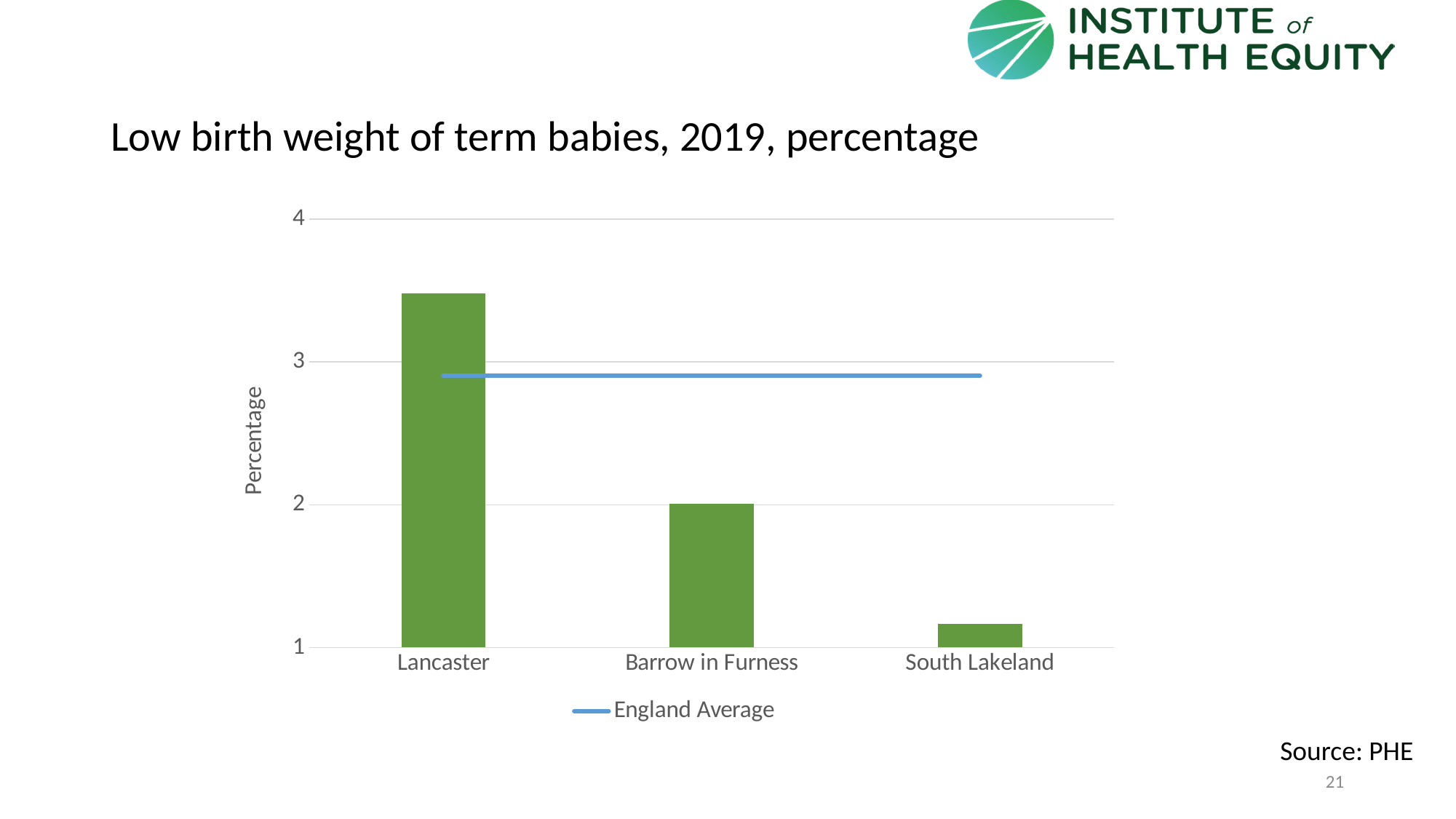
Which area has the lowest low birth weight percentage? South Lakeland Which is larger, the value for Lancaster or the value for Barrow in Furness? Lancaster Is the England Average line above or below the bar for Lancaster? below Is the value for South Lakeland greater or less than 2? less What series does the legend list? England Average How many areas are shown on the x axis? 3 Which area has the highest low birth weight percentage? Lancaster Do the bar values rise or fall from left to right across the x axis? fall Is the value for Lancaster greater or less than 3? greater What type of chart is shown on the slide? combination bar and line chart What is the label on the y axis? Percentage Is the value for Barrow in Furness greater or less than 3? less